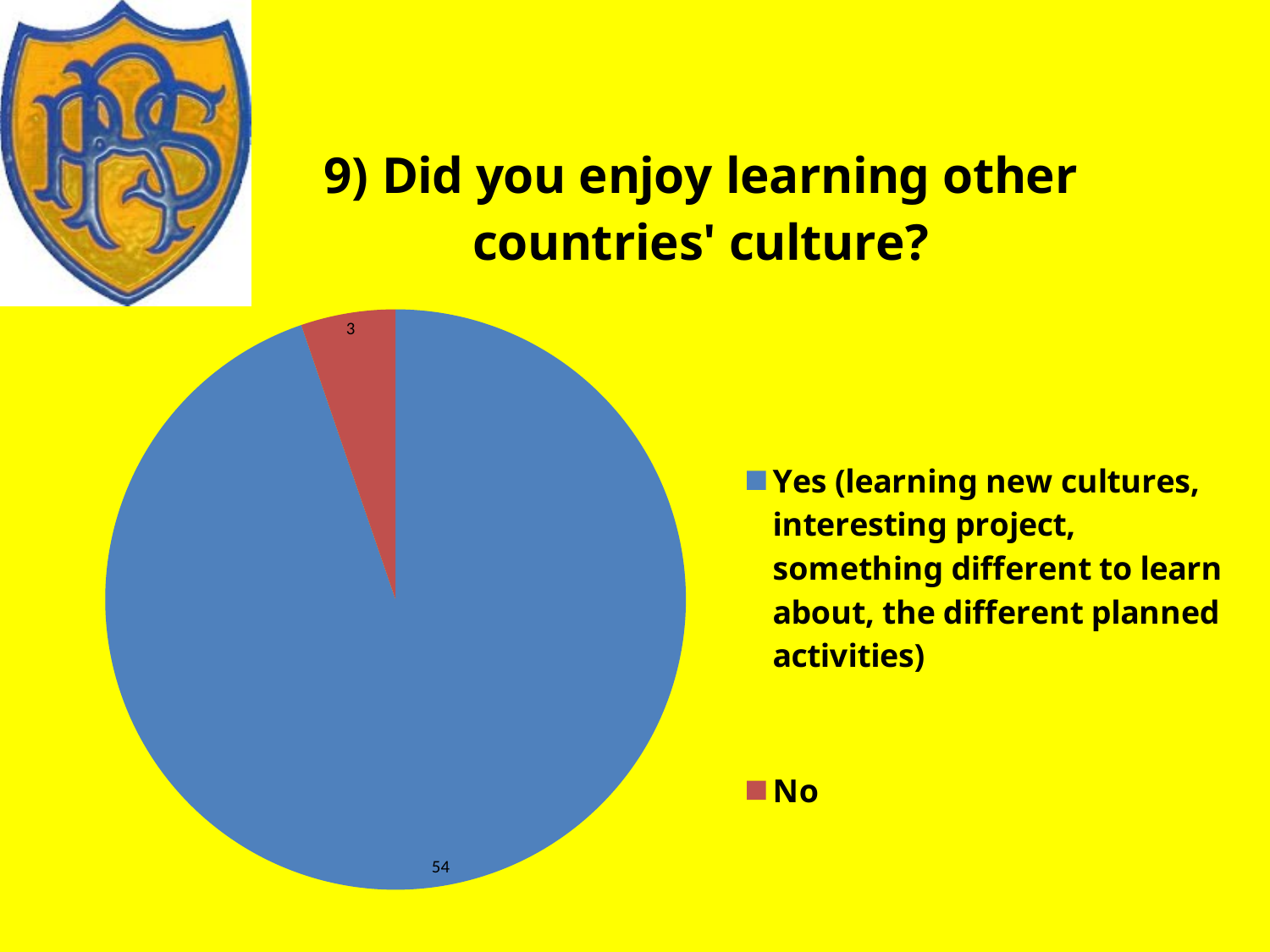
What fraction of all responses does the "Yes" slice represent? 54 out of 57 How many slices does the pie chart have? 2 Which response received more answers, "Yes" or "No"? Yes Which response has the smallest slice of the pie chart? No How many entries does the legend list? 2 What type of chart is shown on the slide? pie chart What is the total number of responses shown in the pie chart? 57 How many respondents answered "No" to the question about enjoying learning other countries' culture? 3 What is the difference between the number of "Yes" and "No" responses? 51 Which response has the largest slice of the pie chart? Yes How many respondents answered "Yes" in the pie chart? 54 What colour is the "No" slice in the pie chart? red